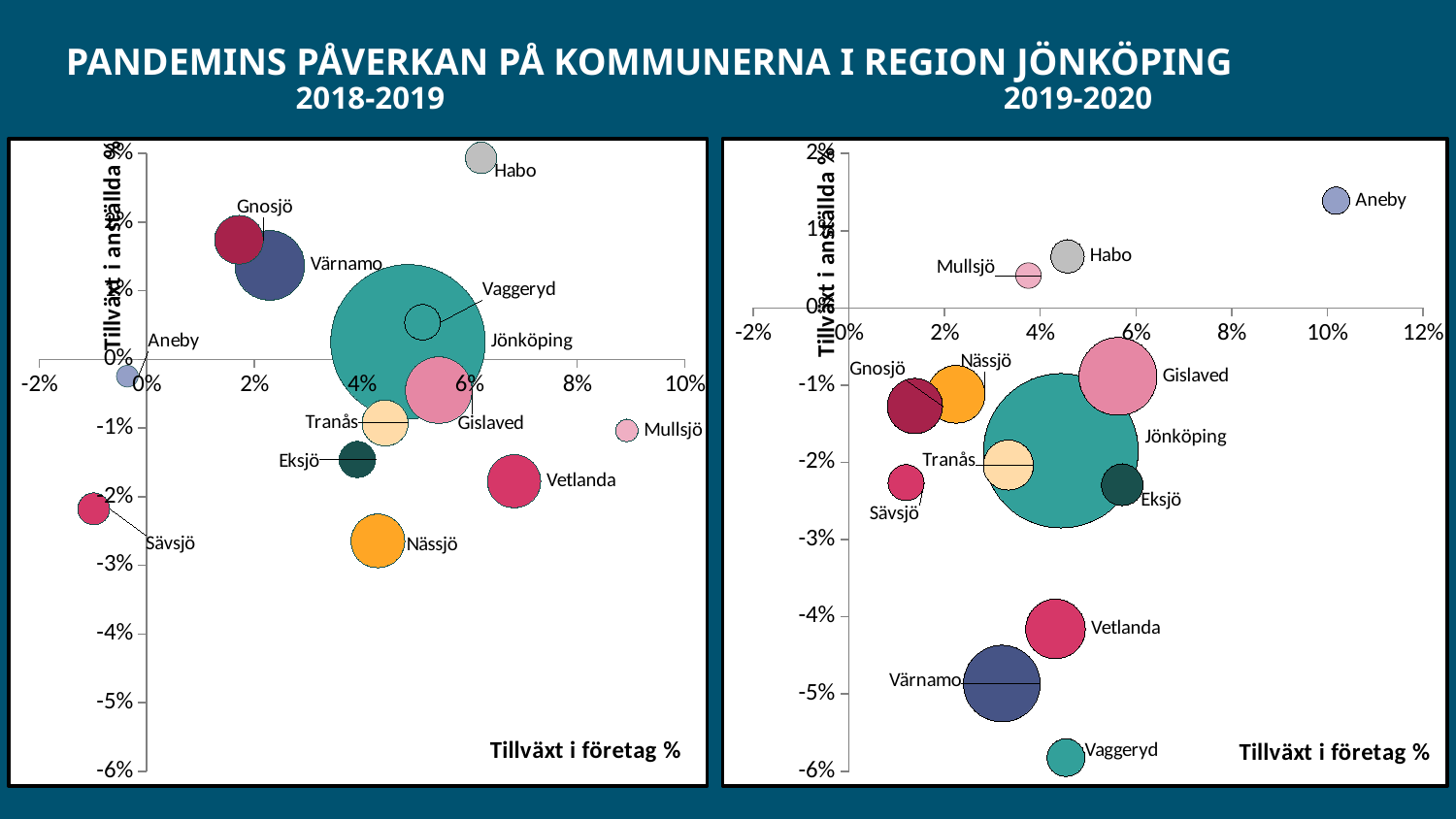
In the 2019-2020 chart, which municipality has the lowest growth in employees (Tillväxt i anställda %)? Vaggeryd In the 2018-2019 chart, which municipality has the highest growth in companies (Tillväxt i företag %)? Mullsjö In the 2018-2019 chart, is the employee growth value for Vetlanda greater or less than -1%? less How many municipalities are plotted in the 2019-2020 chart? 13 What is the label of the horizontal axis in both charts? Tillväxt i företag % In the 2018-2019 chart, which municipality has the lowest growth in employees (Tillväxt i anställda %)? Nässjö In the 2019-2020 chart, which has the higher employee growth, Vetlanda or Värnamo? Vetlanda In the 2018-2019 chart, which municipality has the highest growth in employees (Tillväxt i anställda %)? Habo In the 2019-2020 chart, which municipality has the highest growth in companies (Tillväxt i företag %)? Aneby In the 2019-2020 chart, is the employee growth value for Värnamo greater or less than -4%? less What kind of chart is the 2018-2019 chart on the left? bubble chart